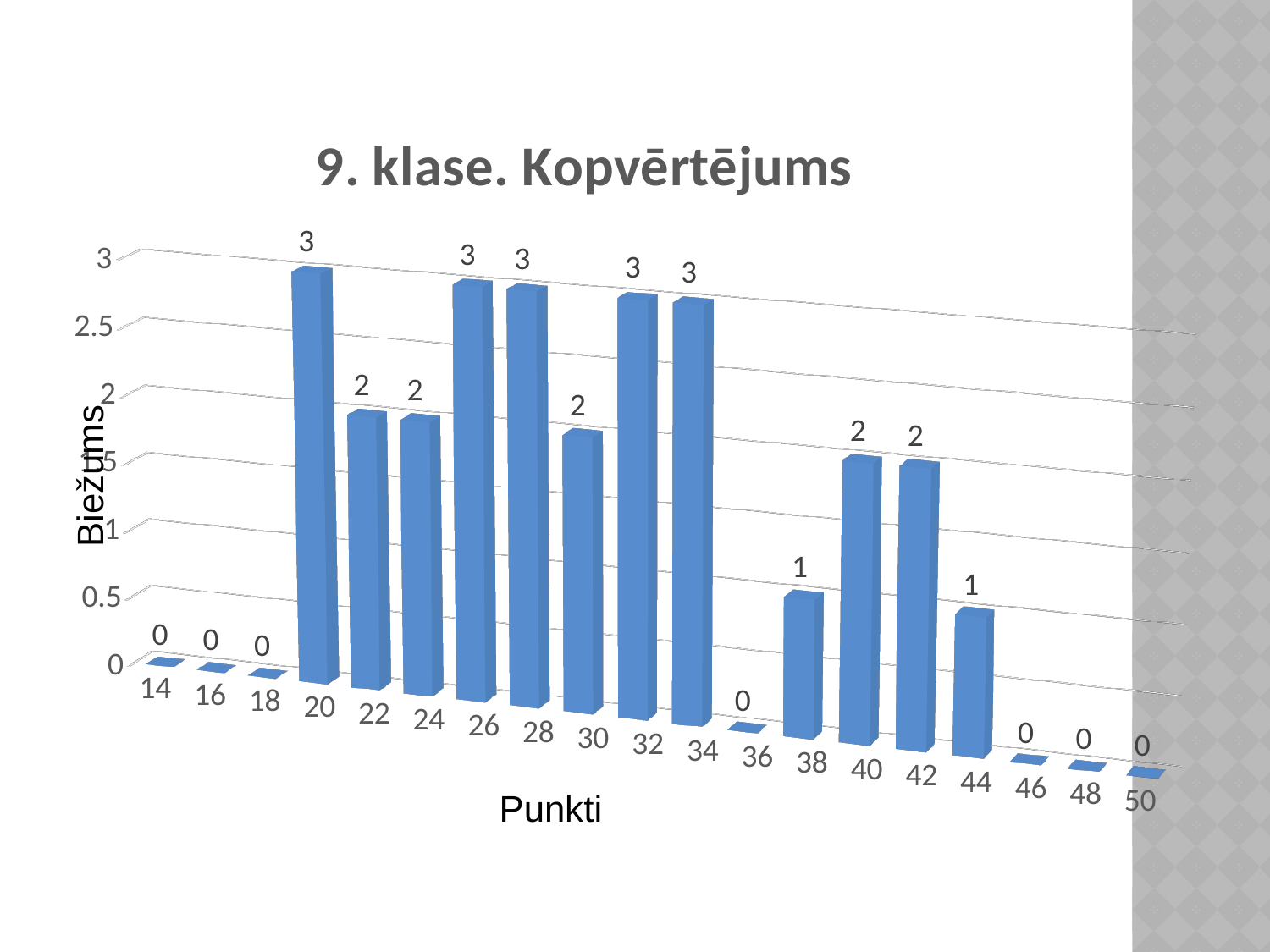
What is the value for 36 points? 0 What is the value for 38 points? 1 What is the value for 20 points? 3 What kind of chart is shown on the slide? bar chart Which has a larger value, 32 points or 40 points? 32 What is the value for 30 points? 2 What is the title of the chart? 9. klase. Kopvērtējums What is the value for 42 points? 2 What is the highest frequency value shown on the chart? 3 How many categories are shown on the x axis? 19 What is the difference between the values for 22 points and 38 points? 1 What is the difference between the values for 26 points and 44 points? 2